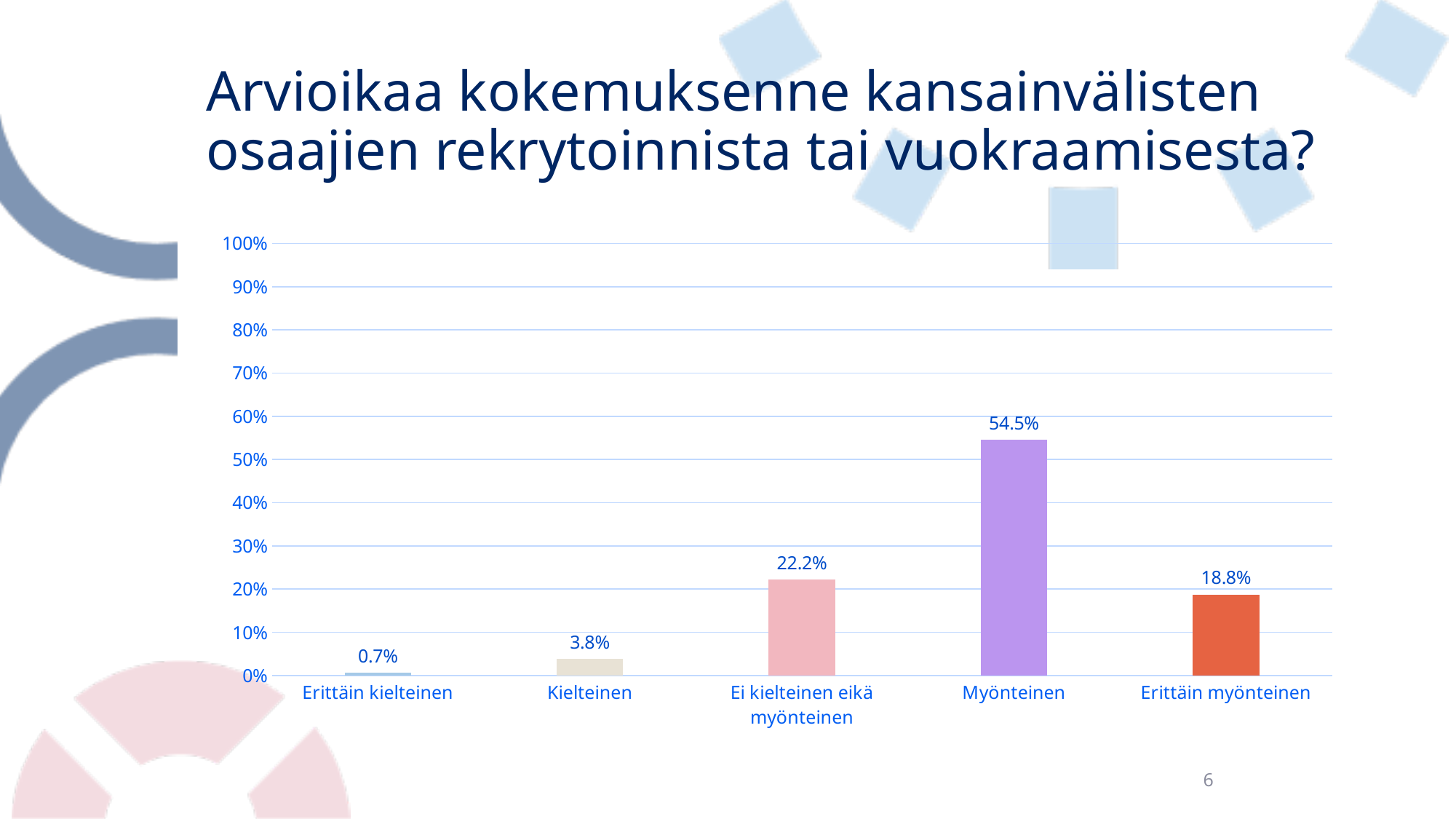
How many categories are shown on the x axis? 5 Which category has the lowest value? Erittäin kielteinen What kind of chart is shown on the slide? bar chart Is the value for Myönteinen greater or less than 50%? greater What is the value for Erittäin myönteinen? 18.8% Which category has the highest value? Myönteinen What is the difference between the values for Myönteinen and Erittäin myönteinen? 35.7% What is the value for Myönteinen? 54.5% What is the value for Erittäin kielteinen? 0.7% What is the highest value shown on the y axis? 100% What is the value for Ei kielteinen eikä myönteinen? 22.2% Which is larger, the value for Kielteinen or the value for Ei kielteinen eikä myönteinen? Ei kielteinen eikä myönteinen